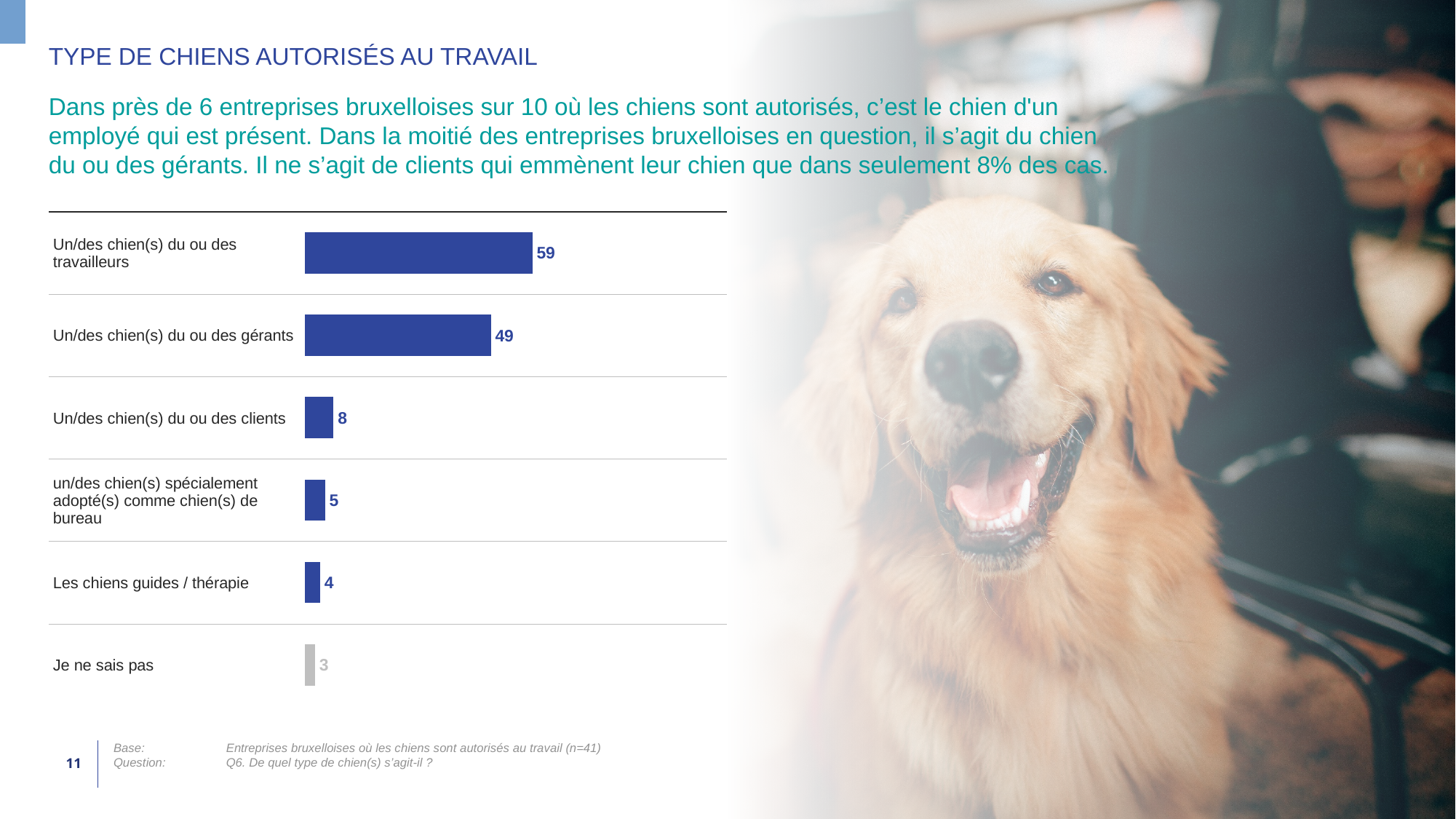
Which category has the lowest value? Je ne sais pas What is the value for "Un/des chien(s) du ou des travailleurs"? 59 What is the difference between the values for "Un/des chien(s) du ou des travailleurs" and "Un/des chien(s) du ou des gérants"? 10 What is the value for "Un/des chien(s) du ou des gérants"? 49 What kind of chart is shown on the slide? Bar chart Which is larger: the value for "Un/des chien(s) du ou des clients" or for "un/des chien(s) spécialement adopté(s) comme chien(s) de bureau"? Un/des chien(s) du ou des clients What is the value for "Les chiens guides / thérapie"? 4 What is the value for "Je ne sais pas"? 3 What is the value for "Un/des chien(s) du ou des clients"? 8 What is the title of the slide containing the chart? TYPE DE CHIENS AUTORISÉS AU TRAVAIL How many categories are shown in the chart? 6 Which category has the highest value? Un/des chien(s) du ou des travailleurs